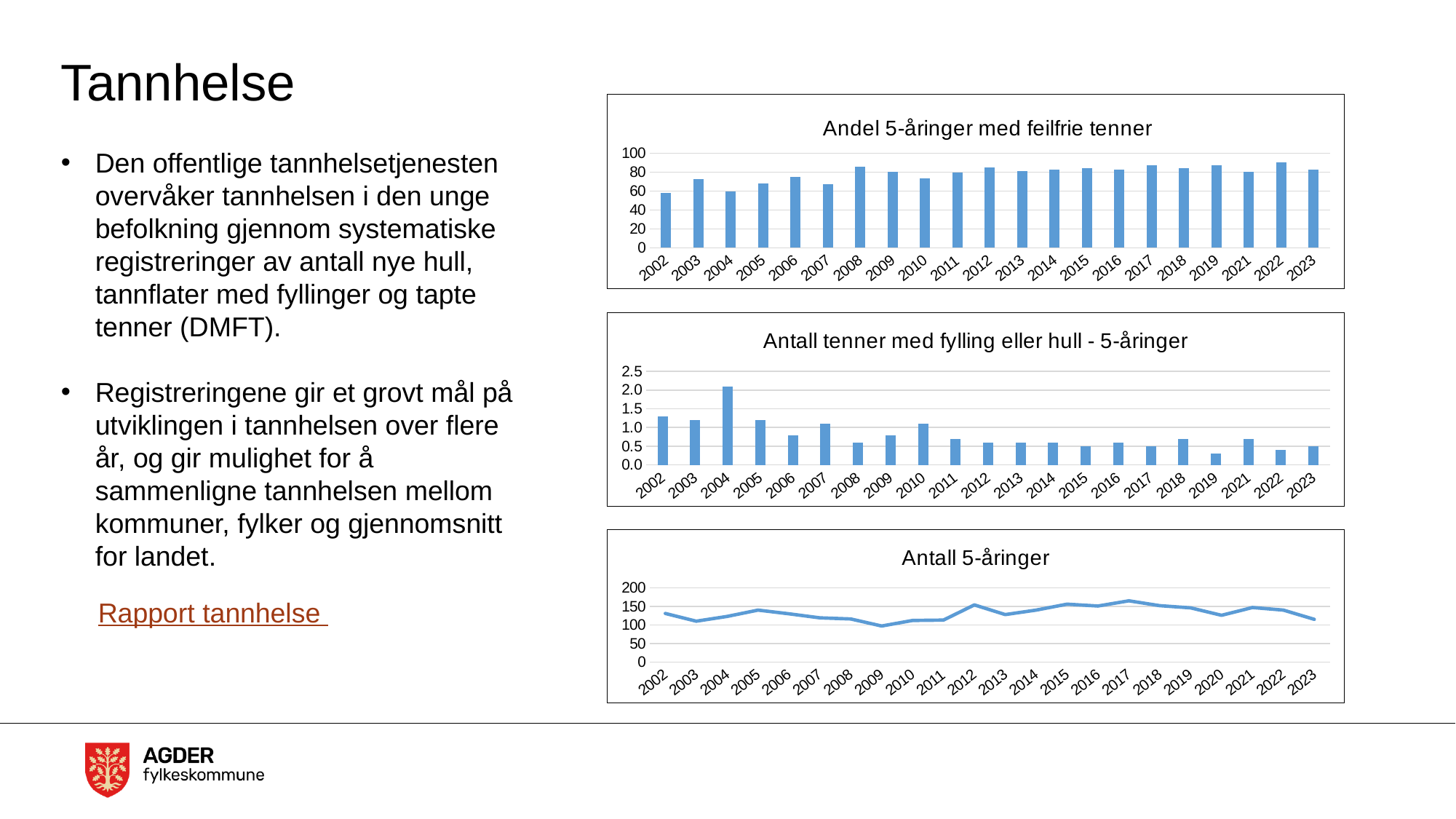
In the 'Antall tenner med fylling eller hull - 5-åringer' chart, which year has the highest value? 2004 In the 'Antall 5-åringer' chart, which year has the highest value? 2017 In the 'Antall tenner med fylling eller hull - 5-åringer' chart, is the value for 2002 greater or less than 1.0? greater In the 'Antall tenner med fylling eller hull - 5-åringer' chart, which year has the lowest value? 2019 In the 'Andel 5-åringer med feilfrie tenner' chart, is the value for 2004 greater or less than 80? less In the 'Antall 5-åringer' chart, is the value for 2003 greater or less than 150? less How many bars are in the 'Antall tenner med fylling eller hull - 5-åringer' chart? 21 What kind of chart is the 'Andel 5-åringer med feilfrie tenner' chart? bar chart In the 'Andel 5-åringer med feilfrie tenner' chart, which year has the highest value? 2022 In the 'Antall tenner med fylling eller hull - 5-åringer' chart, do the values generally rise or fall from 2002 to 2023? fall In the 'Andel 5-åringer med feilfrie tenner' chart, which year has the lowest value? 2002 What kind of chart is the 'Antall 5-åringer' chart? line chart